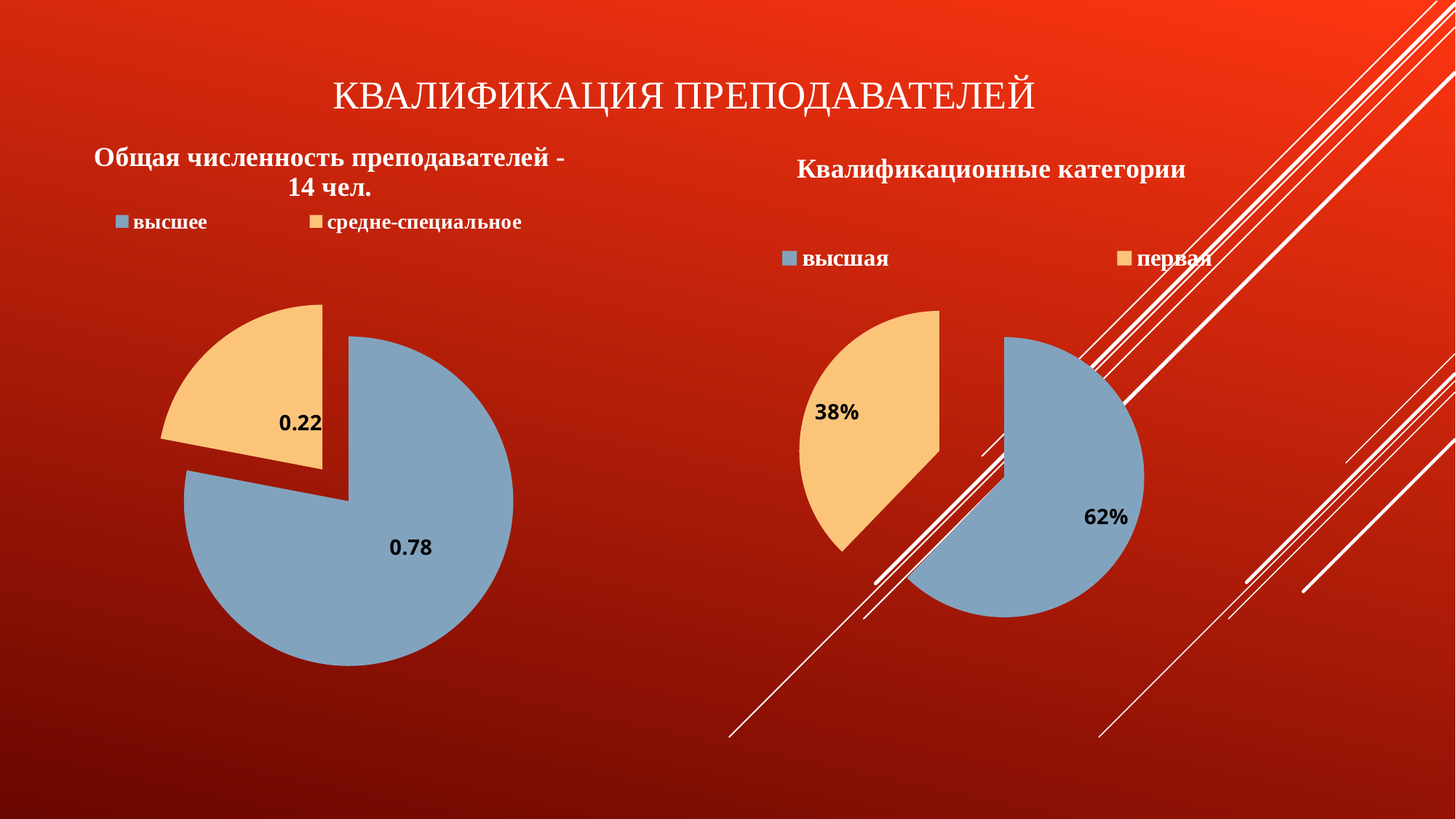
In the right chart, what is the difference between the values for высшая and первая? 24% In the chart titled "Общая численность преподавателей - 14 чел.", what is the value for средне-специальное? 0.22 In the left chart, what is the difference between the values for высшее and средне-специальное? 0.56 How many entries does the legend of the right chart list? 2 In the chart titled "Общая численность преподавателей - 14 чел.", what is the value for высшее? 0.78 In the right chart, which category has the smallest slice? первая In the chart titled "Квалификационные категории", what is the value for первая? 38% How many slices does the left pie chart have? 2 What kind of chart is the chart titled "Квалификационные категории"? pie chart In the left chart, which is larger: высшее or средне-специальное? высшее In the left chart, which category has the largest slice? высшее In the chart titled "Квалификационные категории", what is the value for высшая? 62%